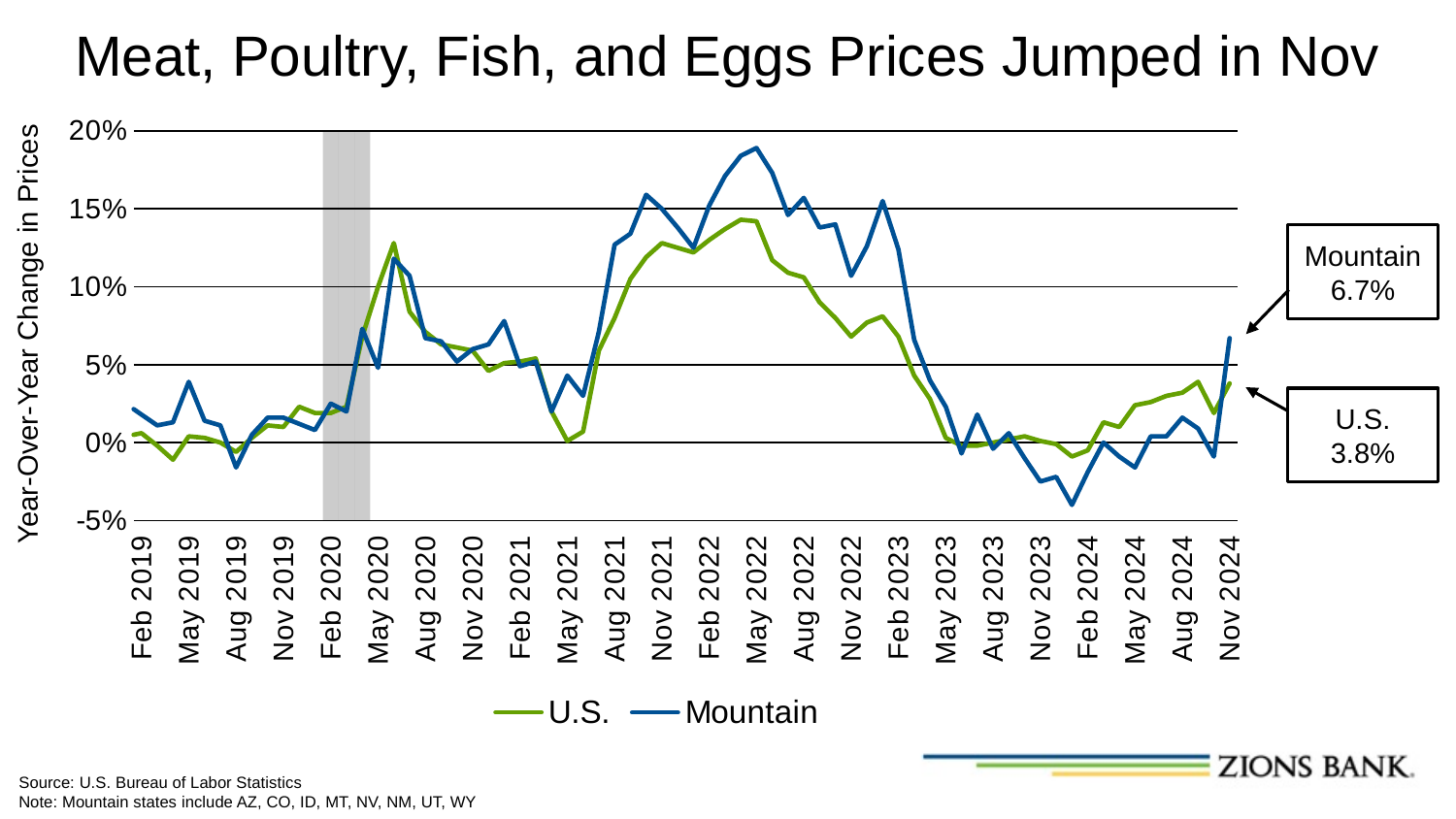
Which series reaches the higher peak over the whole period, U.S. or Mountain? Mountain Is the Mountain value in Feb 2024 greater or less than 0%? less Is the peak value of the U.S. series in 2022 greater or less than 15%? less Between May 2022 and May 2023, does the U.S. series rise or fall? Fall In Nov 2024, which series has the higher value, U.S. or Mountain? Mountain What is the label on the vertical axis of the chart? Year-Over-Year Change in Prices By how many percentage points does the Mountain value exceed the U.S. value in Nov 2024? 2.9 percentage points What is the year-over-year change in prices for the Mountain region in Nov 2024? 6.7% What kind of chart is shown on the slide? Line chart What is the year-over-year change in prices for the U.S. in Nov 2024? 3.8% Is the peak value of the Mountain series in 2022 greater or less than 15%? greater How many series does the legend list? 2